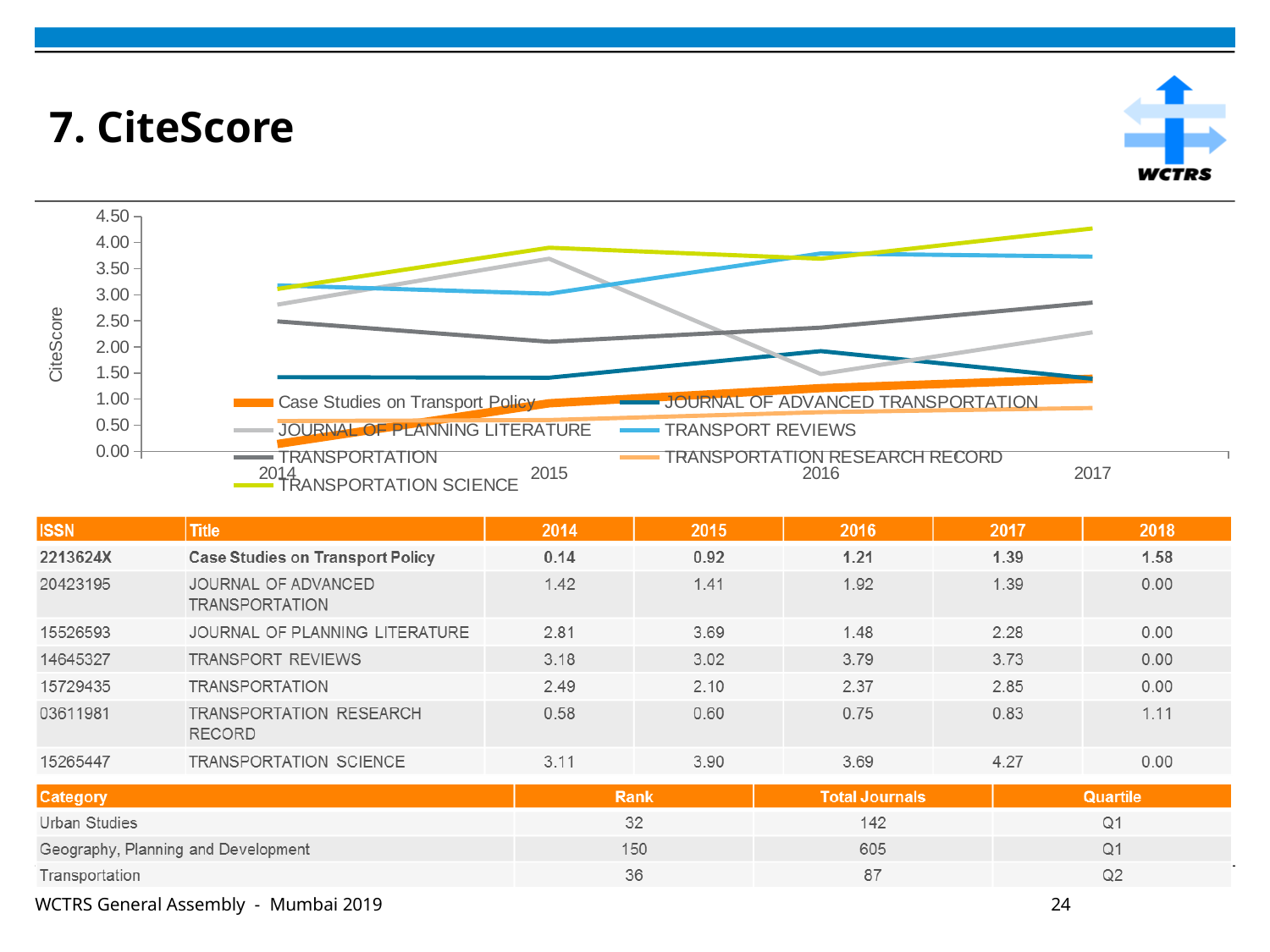
Which journal has the lowest CiteScore in 2014? Case Studies on Transport Policy In 2015, which has the higher CiteScore: JOURNAL OF PLANNING LITERATURE or TRANSPORTATION? JOURNAL OF PLANNING LITERATURE Does the CiteScore for Case Studies on Transport Policy rise or fall from 2014 to 2017? rise Which journal has the highest CiteScore in 2017? TRANSPORTATION SCIENCE Is the CiteScore for TRANSPORT REVIEWS in 2016 greater or less than 3.50? greater What kind of chart is shown on the slide? line chart How many series does the chart's legend list? 7 How many years are plotted along the x axis of the chart? 4 What is the label on the chart's y axis? CiteScore What is the difference between the 2017 CiteScores of TRANSPORTATION SCIENCE and TRANSPORT REVIEWS? 0.54 What is the CiteScore for TRANSPORTATION SCIENCE in 2017? 4.27 What is the CiteScore for TRANSPORTATION RESEARCH RECORD in 2016? 0.75